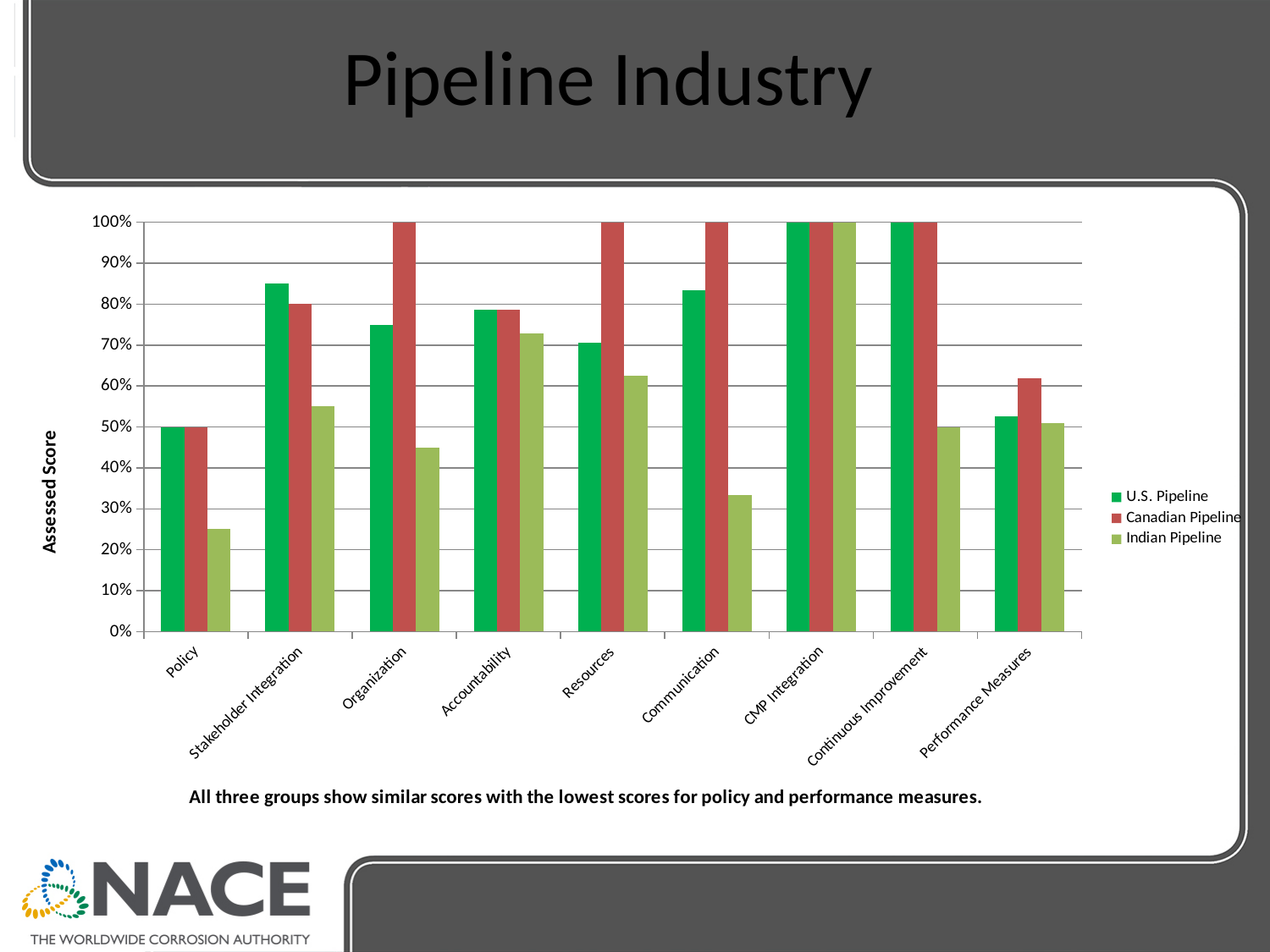
Is the Indian Pipeline value for Communication greater or less than 40%? less What kind of chart is shown on the slide? bar chart What is the U.S. Pipeline value for Policy? 50% Which category has the lowest Indian Pipeline value? Policy What is the label on the vertical axis? Assessed Score Is the Indian Pipeline value for Policy greater or less than 30%? less What is the Canadian Pipeline value for Stakeholder Integration? 80% What is the Canadian Pipeline value for CMP Integration? 100% Which is larger for Organization, the U.S. Pipeline value or the Canadian Pipeline value? Canadian Pipeline How many categories are shown on the x axis? 9 What is the Indian Pipeline value for Continuous Improvement? 50% How many series does the legend list? 3